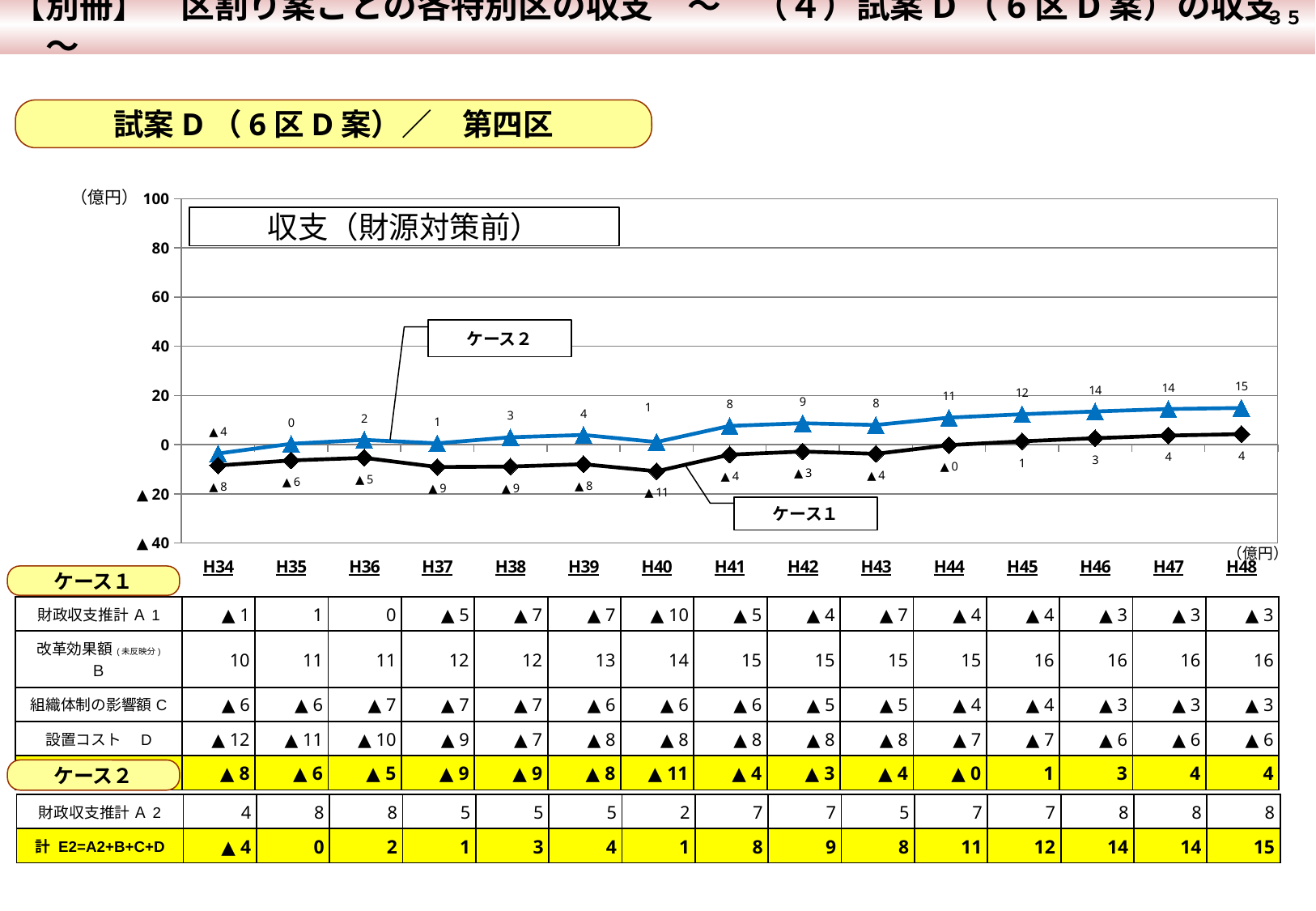
What type of chart is shown on the slide? line chart What is the value of ケース2 at H34? ▲4 What is the difference between ケース2 and ケース1 at H48? 11 How many years are plotted on the x axis of the chart? 15 What is the value of ケース1 at H40? ▲11 In which year does ケース2 reach its highest value? H48 How many series are plotted in the chart? 2 What is the value of ケース2 at H48? 15 What is the value of ケース1 at H45? 1 Is the value of ケース2 at H48 greater or less than 20? less At H42, which series has the larger value, ケース1 or ケース2? ケース2 In which year does ケース1 reach its lowest value? H40